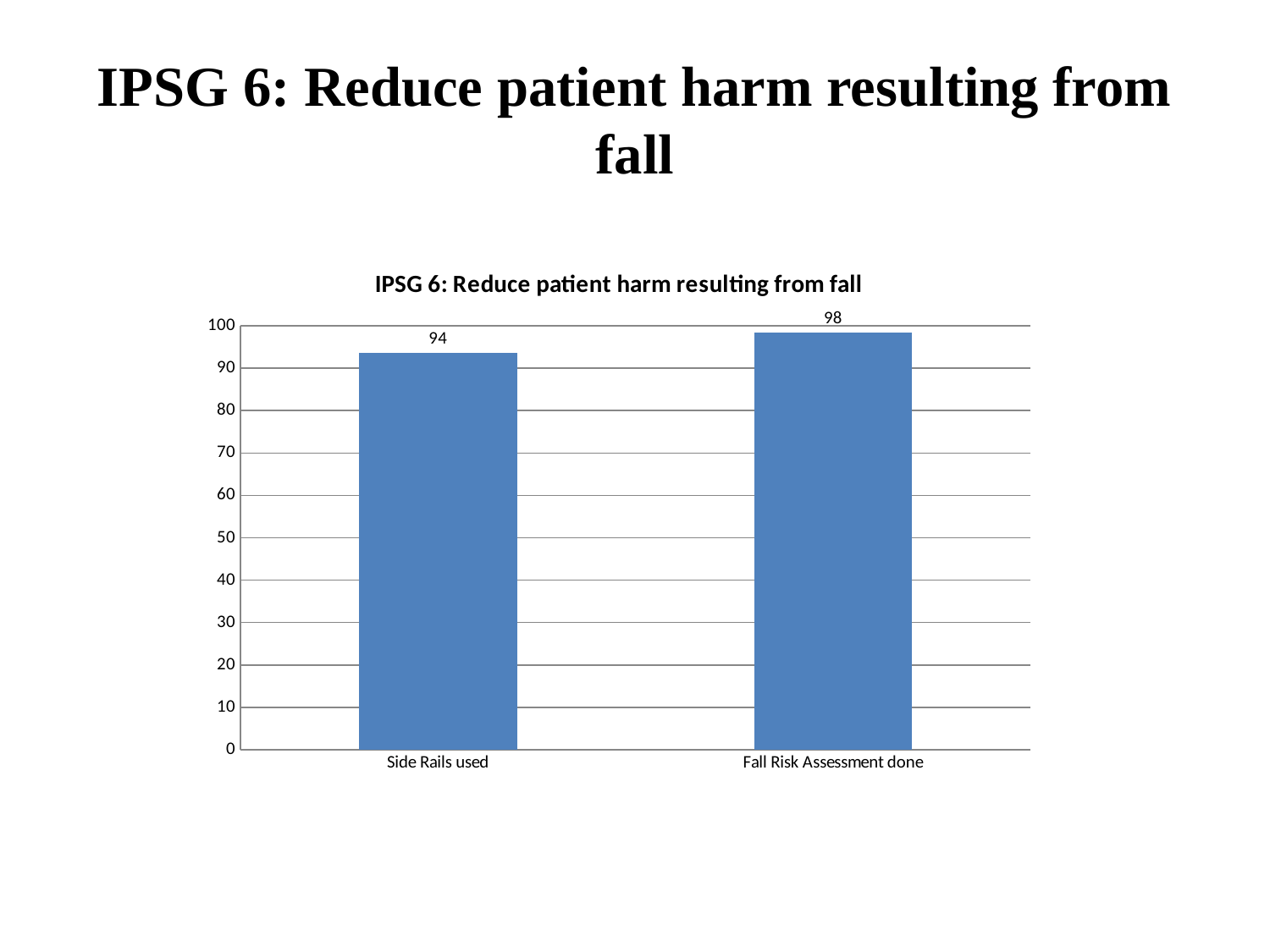
What is the difference between the values for Fall Risk Assessment done and Side Rails used? 4 Which is larger, the value for Side Rails used or the value for Fall Risk Assessment done? Fall Risk Assessment done What is the value for Side Rails used? 94 What is the title of the chart? IPSG 6: Reduce patient harm resulting from fall Which category has the lowest value? Side Rails used Is the value for Fall Risk Assessment done greater or less than 100? less Is the value for Side Rails used greater or less than 90? greater How many categories are shown on the chart? 2 Which category has the highest value? Fall Risk Assessment done What is the value for Fall Risk Assessment done? 98 What is the maximum value shown on the vertical axis? 100 What kind of chart is shown on the slide? Bar chart